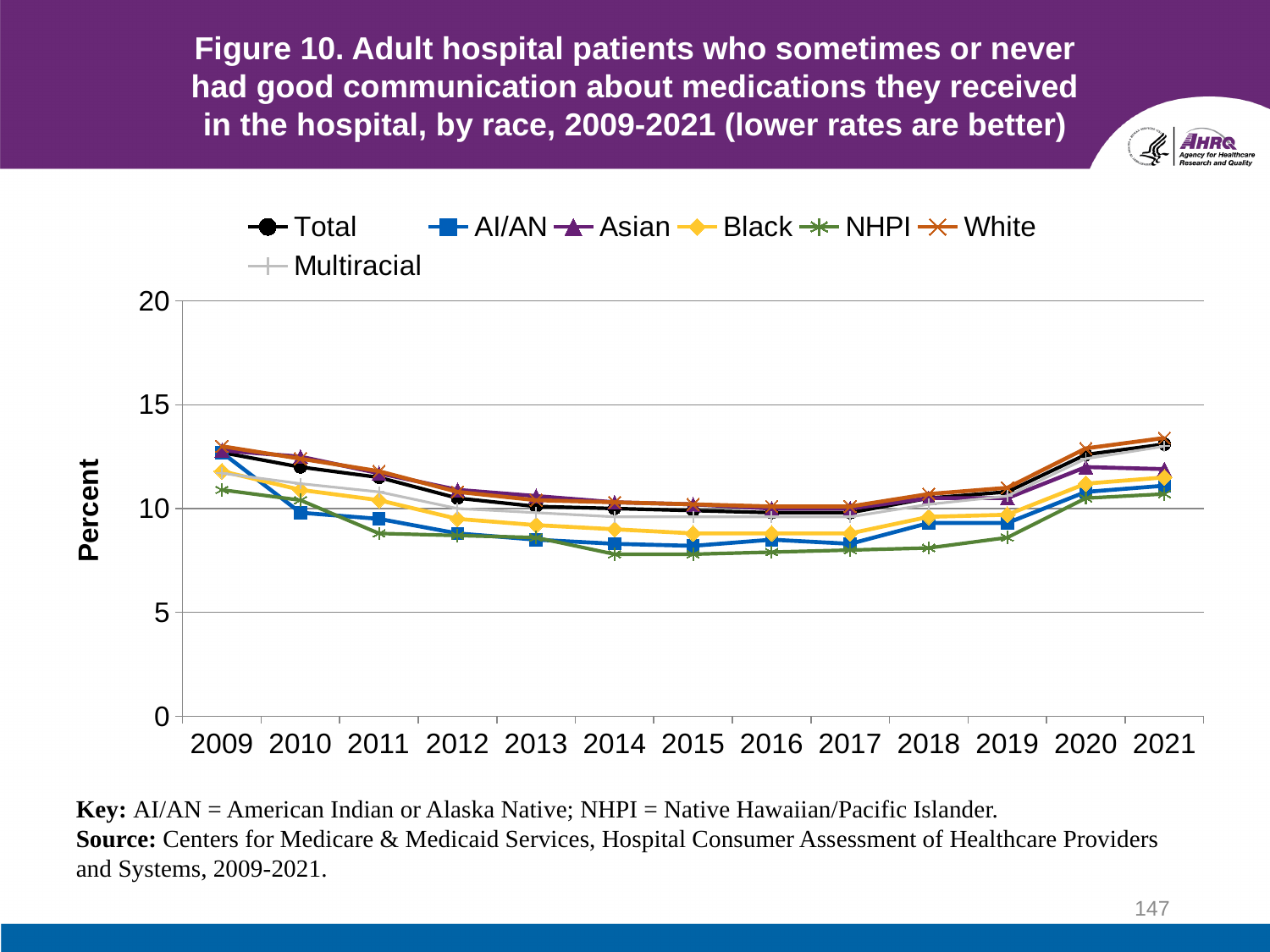
Is the value for AI/AN in 2013 greater or less than 10? less Is the value for NHPI in 2014 greater or less than 10? less In 2014, which is larger, the value for White or the value for NHPI? White What kind of chart is shown on the slide? Line chart Does the Total line rise or fall from 2017 to 2021? Rise Which race group has the lowest value in 2009? NHPI Is the value for White in 2021 greater or less than 15? less Does the Total line rise or fall from 2009 to 2016? Fall How many series does the legend list? 7 How many years are shown along the x axis? 13 What is the label on the y axis? Percent